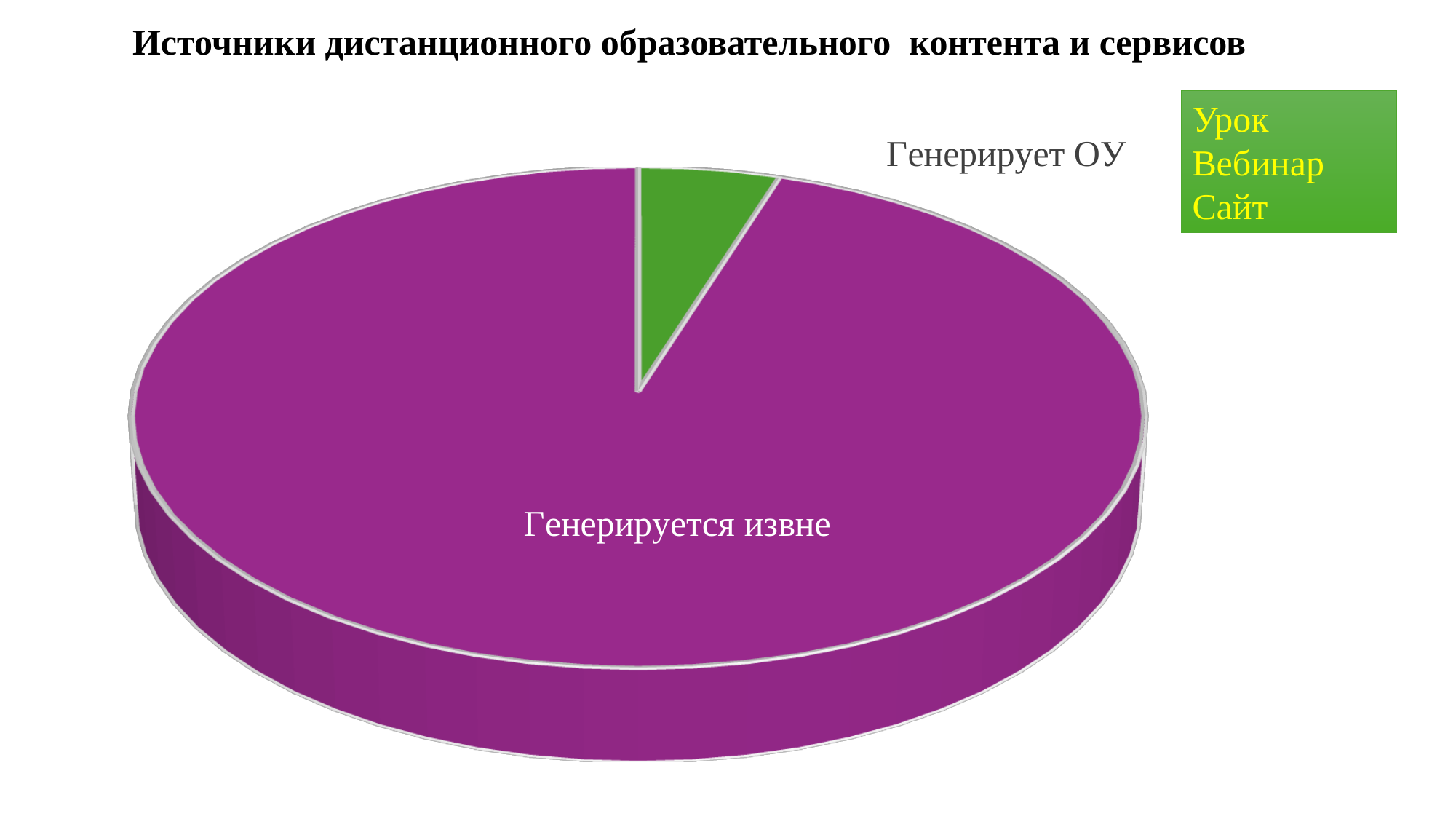
Which slice of the pie chart is the smallest? Генерирует ОУ How many slices does the pie chart have? 2 What colour is the "Генерирует ОУ" slice of the pie chart? Green Which slice is larger, "Генерирует ОУ" or "Генерируется извне"? Генерируется извне What is the title of the chart on the slide? Источники дистанционного образовательного контента и сервисов What kind of chart is shown on the slide? Pie chart Which slice of the pie chart is the largest? Генерируется извне